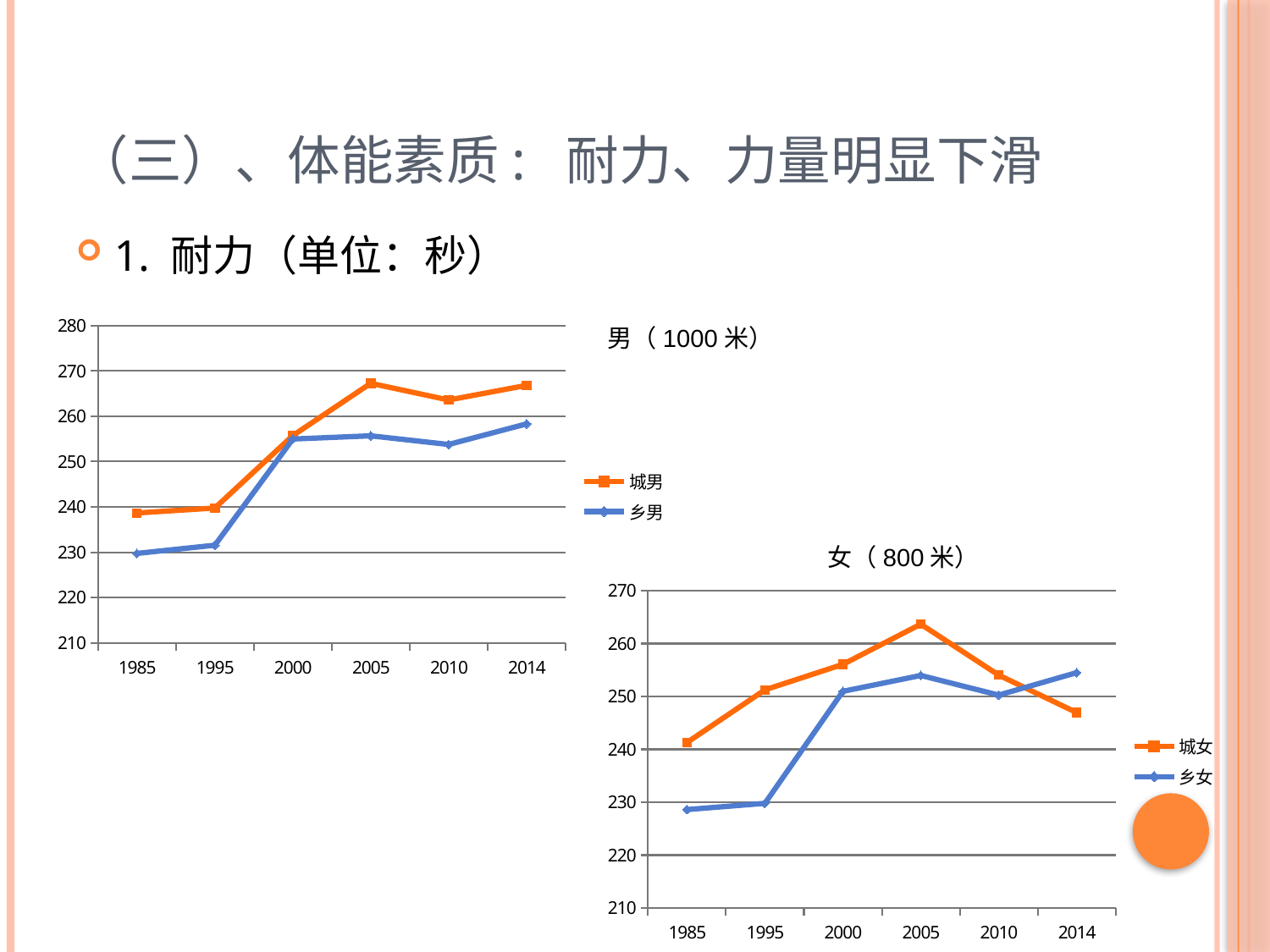
In the 女（800米） chart, in which year is the 城女 value lowest? 1985 In the 男（1000米） chart, is the value for 乡男 in 1985 greater or less than 240? less In the 男（1000米） chart, is the value for 城男 in 2005 greater or less than 260? greater In the 男（1000米） chart, which series has the larger value in 2005, 城男 or 乡男? 城男 How many years are shown on the x axis of the 男（1000米） chart? 6 How many series does the legend of the 女（800米） chart list? 2 What kind of chart is the 男（1000米） chart? line chart In the 女（800米） chart, which series has the larger value in 2014, 城女 or 乡女? 乡女 In the 女（800米） chart, does the 城女 line rise or fall from 2005 to 2014? fall In the 女（800米） chart, is the value for 城女 in 2014 greater or less than 250? less In the 女（800米） chart, in which year is the 城女 value highest? 2005